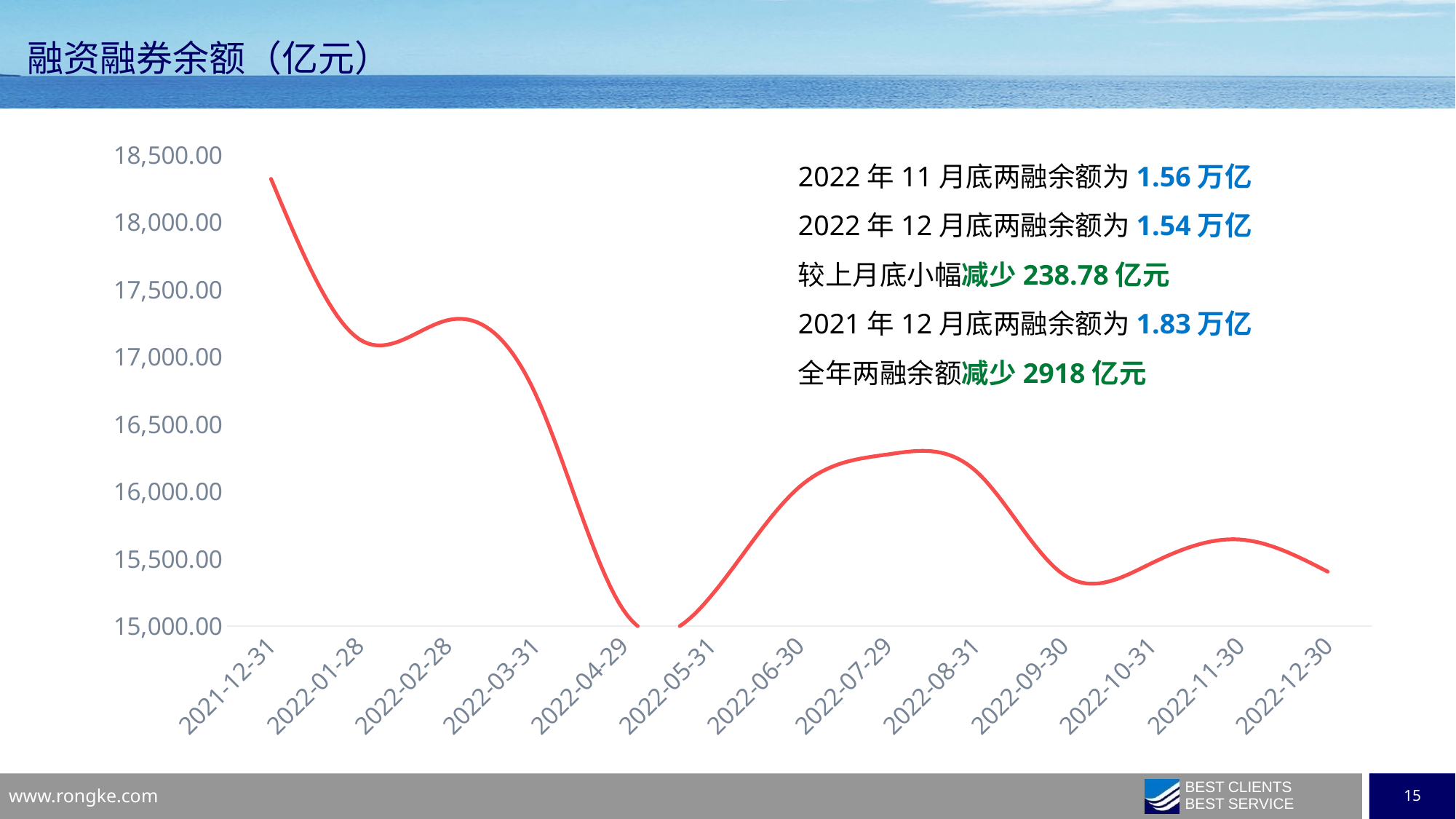
Which date on the x axis has the highest value on the line? 2021-12-31 Is the value for 2022-07-29 greater or less than 16,500.00? less Is the value for 2022-12-30 greater or less than 15,500.00? less Is the value for 2022-02-28 greater or less than 17,500.00? less How many dates are labelled on the x axis of the chart? 13 What kind of chart is shown on the slide? line chart Which is larger, the value for 2022-07-29 or the value for 2022-09-30? 2022-07-29 What is the title of the chart? 融资融券余额（亿元） Overall, does the line rise or fall from 2021-12-31 to 2022-12-30? fall Which is larger, the value for 2021-12-31 or the value for 2022-12-30? 2021-12-31